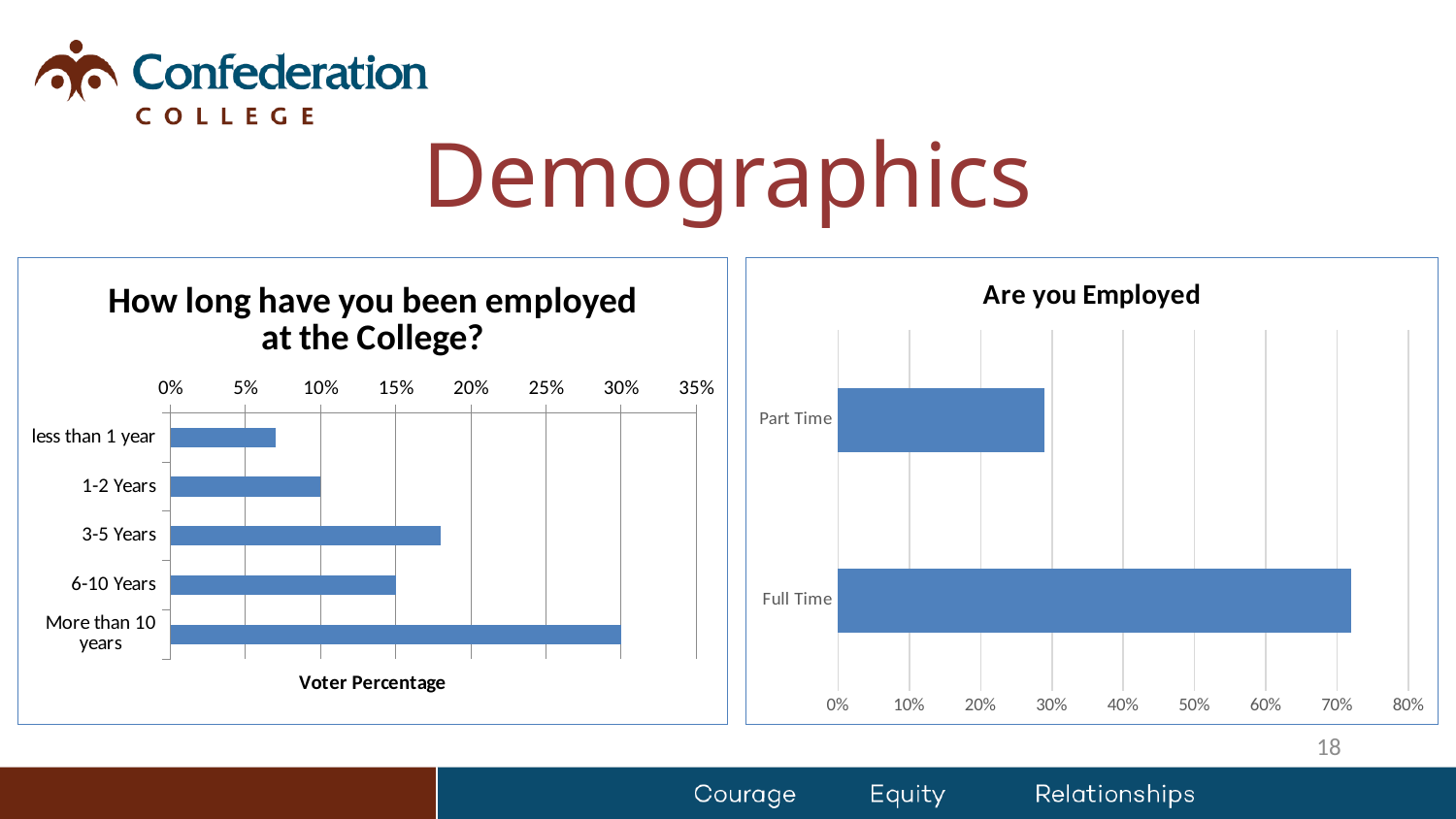
In the chart 'How long have you been employed at the College?', which category has the lowest voter percentage? less than 1 year In the chart 'How long have you been employed at the College?', what is the voter percentage for '6-10 Years'? 15% In the chart 'How long have you been employed at the College?', which is larger: '3-5 Years' or '6-10 Years'? 3-5 Years In the chart 'How long have you been employed at the College?', what is the x-axis title? Voter Percentage In the chart 'How long have you been employed at the College?', which category has the highest voter percentage? More than 10 years In the chart 'How long have you been employed at the College?', is the value for '3-5 Years' greater or less than 15%? greater In the chart 'How long have you been employed at the College?', what is the voter percentage for '1-2 Years'? 10% In the chart 'Are you Employed', which category has the higher value? Full Time In the chart 'How long have you been employed at the College?', what type of chart is shown? bar chart In the chart 'How long have you been employed at the College?', how many categories are shown? 5 In the chart 'How long have you been employed at the College?', what is the voter percentage for 'More than 10 years'? 30%